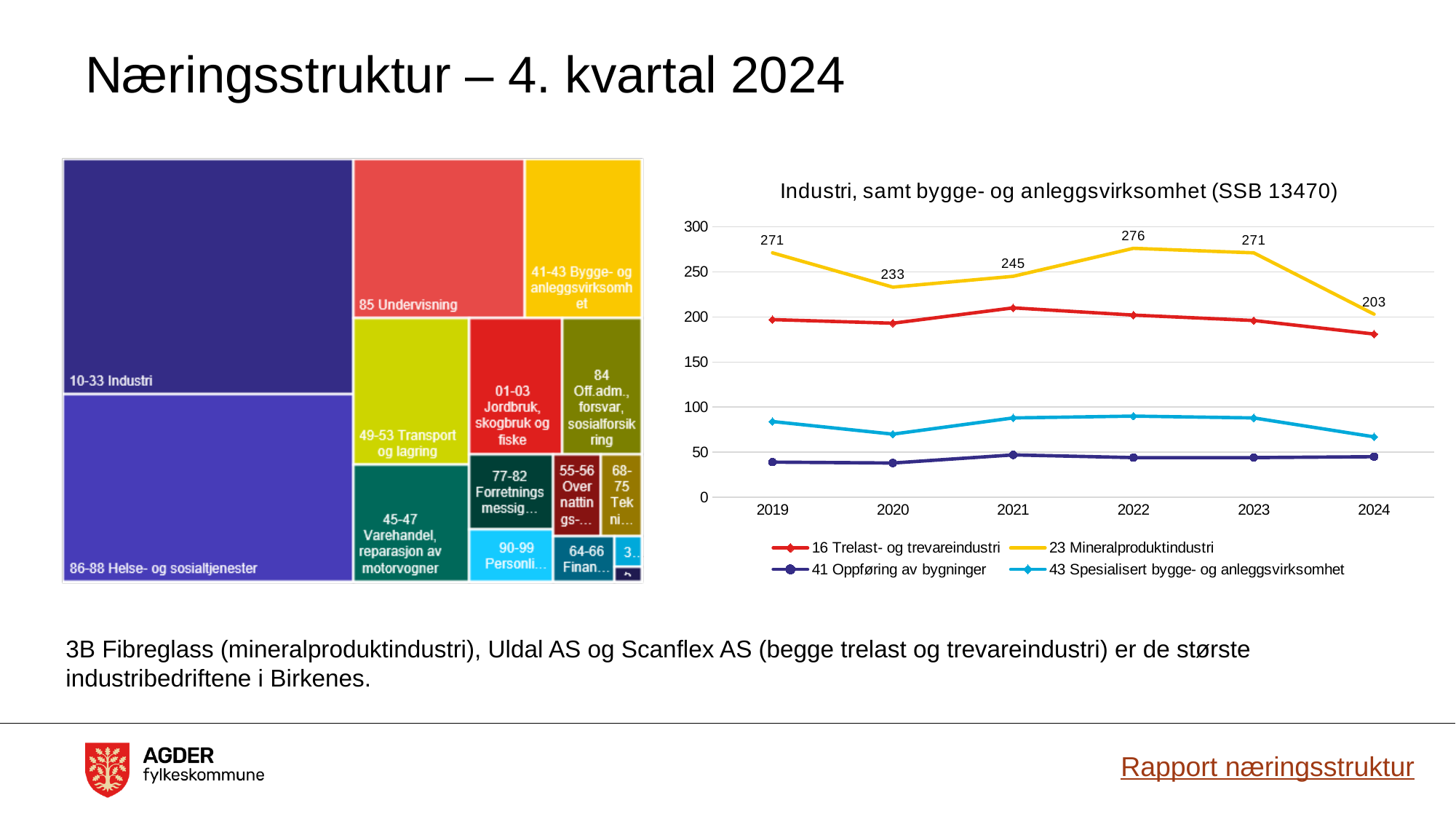
In the line chart 'Industri, samt bygge- og anleggsvirksomhet (SSB 13470)', what is the value for 23 Mineralproduktindustri in 2022? 276 In the line chart on the right, does the value for 23 Mineralproduktindustri rise or fall from 2022 to 2024? fall In the line chart on the right, how many years are shown on the x axis? 6 In the line chart on the right, how many series does the legend list? 4 In the line chart on the right, is the value for 16 Trelast- og trevareindustri in 2021 greater or less than 200? greater In the line chart on the right, is the value for 43 Spesialisert bygge- og anleggsvirksomhet in 2024 greater or less than 100? less In the line chart on the right, by how much did 23 Mineralproduktindustri fall from 2023 to 2024? 68 In the line chart on the right, in which year does 23 Mineralproduktindustri have its lowest value? 2024 In the line chart on the right, what is the value for 23 Mineralproduktindustri in 2020? 233 In the line chart on the right, what is the value for 23 Mineralproduktindustri in 2024? 203 In the line chart on the right, in which year does 23 Mineralproduktindustri reach its highest value? 2022 In the line chart on the right, which series has the higher value in 2019: 23 Mineralproduktindustri or 16 Trelast- og trevareindustri? 23 Mineralproduktindustri